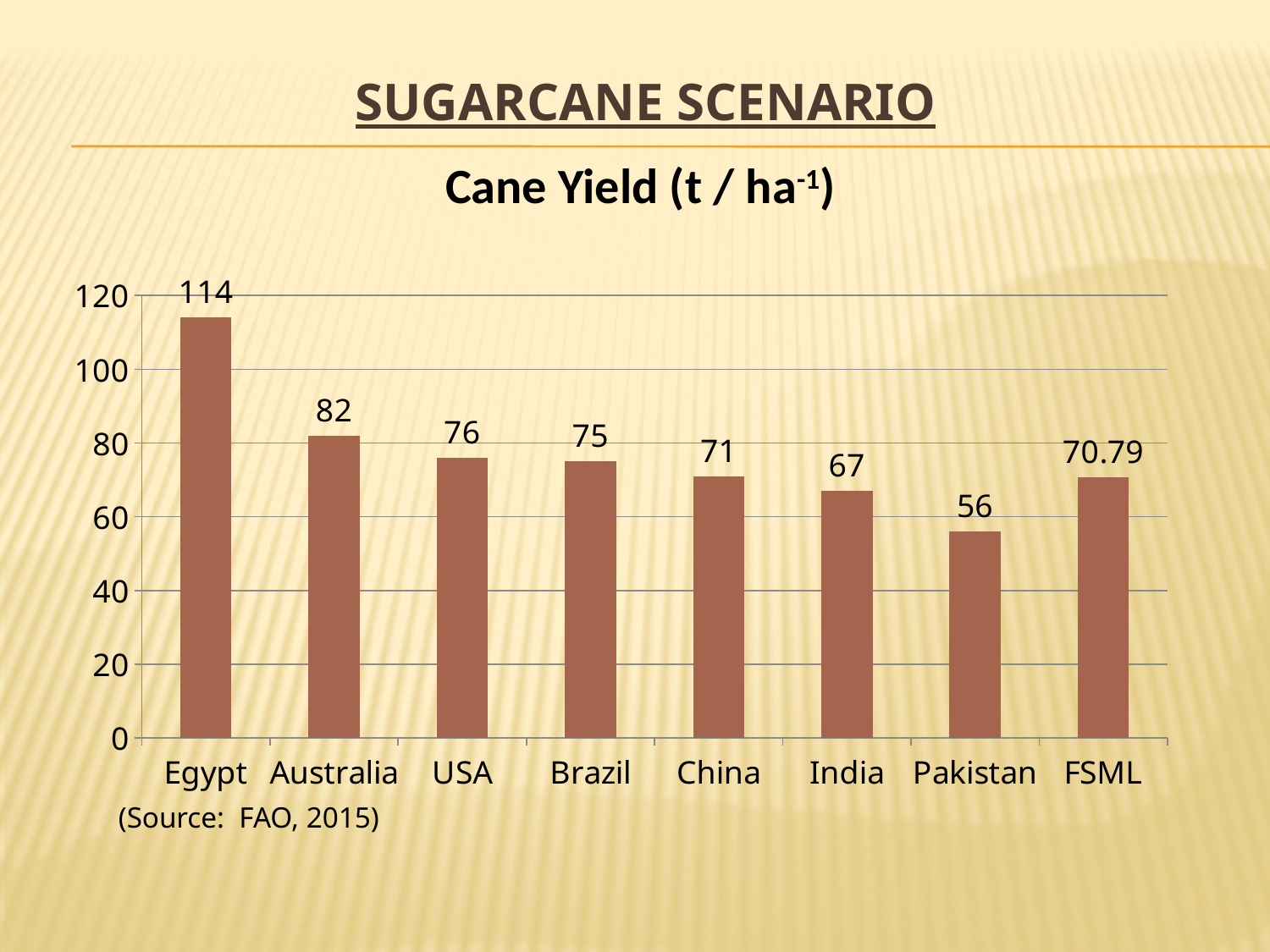
What is the cane yield for FSML? 70.79 What is the difference in cane yield between India and Pakistan? 11 Is the cane yield for Australia greater or less than 80? greater What is the cane yield for Egypt? 114 Which has a higher cane yield, China or India? China What kind of chart is shown on the slide? Bar chart What is the difference in cane yield between Egypt and Australia? 32 Which category has the lowest cane yield? Pakistan What is the source cited below the chart? FAO, 2015 What is the cane yield for Pakistan? 56 How many categories are shown on the x axis? 8 Which country has the highest cane yield? Egypt